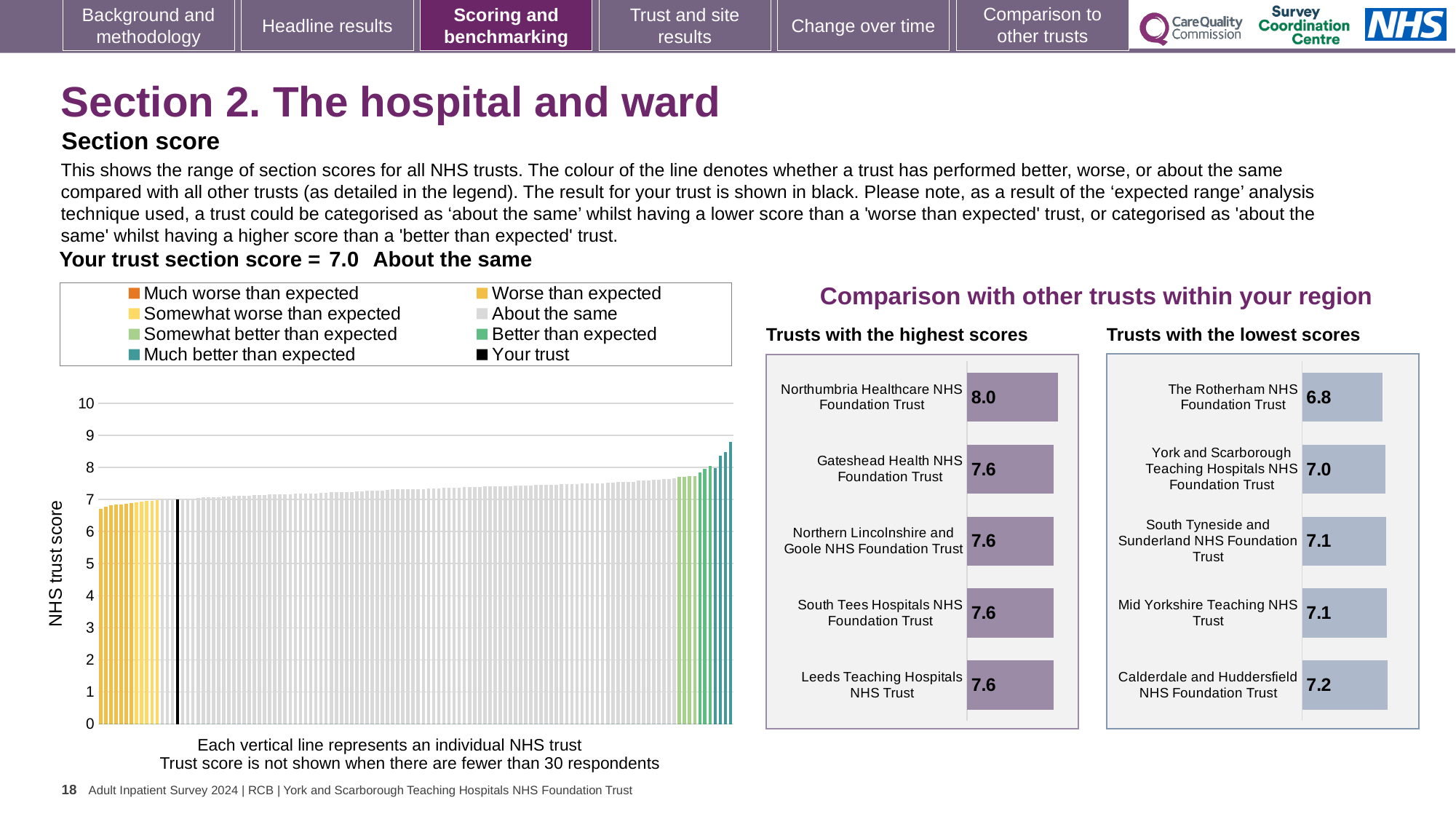
In the 'Trusts with the lowest scores' chart, what is the score for The Rotherham NHS Foundation Trust? 6.8 In the 'Trusts with the highest scores' chart, what is the score for Northumbria Healthcare NHS Foundation Trust? 8.0 What kind of chart is the large 'NHS trust score' chart on the left of the slide? Bar chart In the 'Trusts with the lowest scores' chart, what is the score for Calderdale and Huddersfield NHS Foundation Trust? 7.2 In the 'Trusts with the highest scores' chart, which trust has the highest score? Northumbria Healthcare NHS Foundation Trust How many trusts are shown in the 'Trusts with the highest scores' chart? 5 In the 'Trusts with the lowest scores' chart, which has the larger score: Calderdale and Huddersfield NHS Foundation Trust or The Rotherham NHS Foundation Trust? Calderdale and Huddersfield NHS Foundation Trust In the 'Trusts with the lowest scores' chart, which trust has the lowest score? The Rotherham NHS Foundation Trust In the 'NHS trust score' chart on the left, is the value of the tallest bar greater or less than 8? greater How many entries does the legend of the 'NHS trust score' chart on the left list? 8 How many trusts are shown in the 'Trusts with the lowest scores' chart? 5 In the 'Trusts with the highest scores' chart, what is the difference between the scores of Northumbria Healthcare NHS Foundation Trust and Gateshead Health NHS Foundation Trust? 0.4